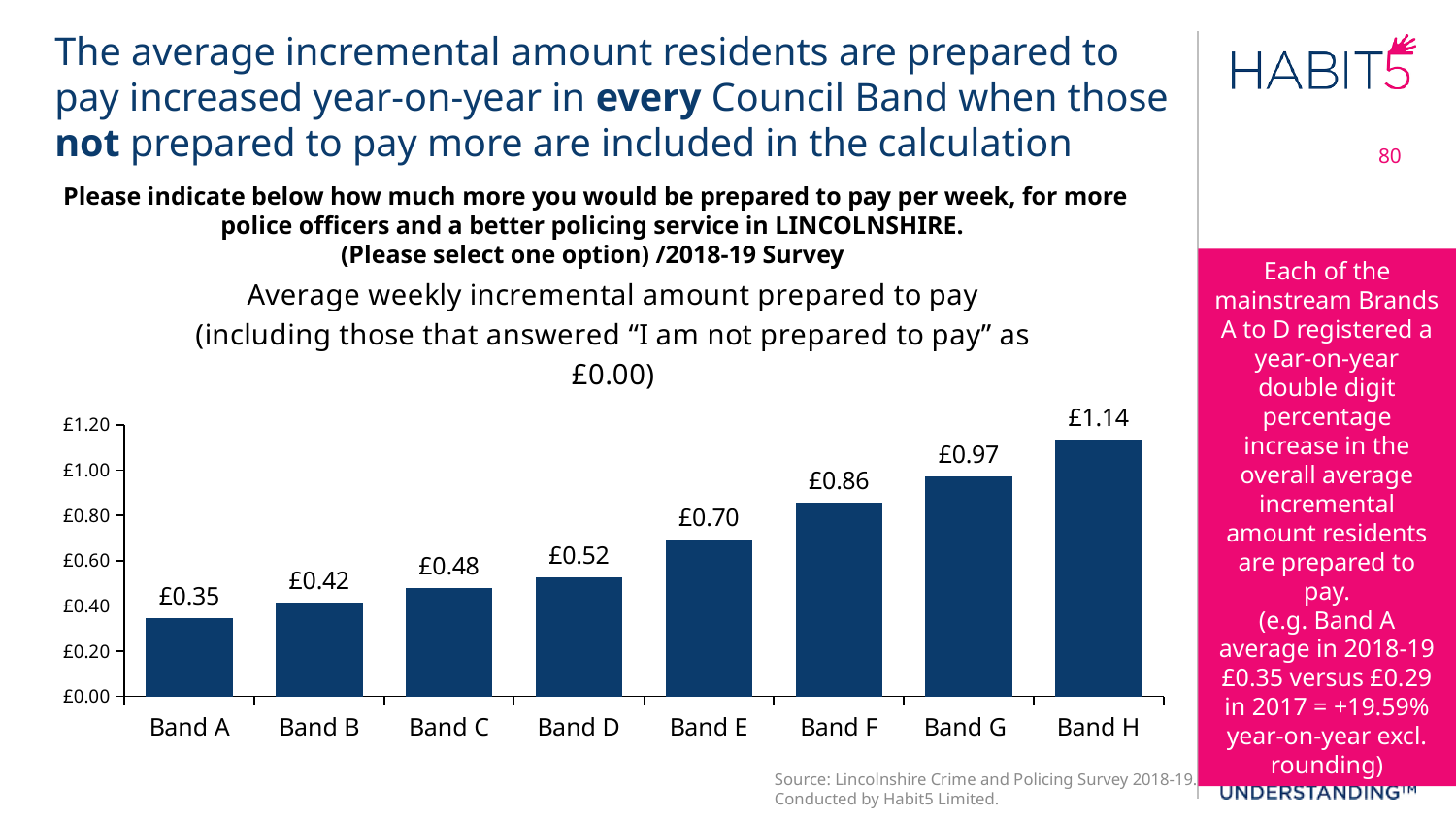
What is the value shown for Band E? £0.70 What is the difference between the values for Band H and Band A? £0.79 Is the value for Band G greater or less than £1.00? less What is the average weekly incremental amount prepared to pay for Band A? £0.35 Do the values rise or fall from Band A to Band H? rise What is the difference between the values for Band F and Band D? £0.34 What kind of chart is shown on the slide? bar chart Which is larger, the value for Band C or the value for Band F? Band F How many Council Bands are shown on the chart? 8 Which Council Band has the lowest average weekly incremental amount? Band A Which Council Band has the highest average weekly incremental amount? Band H What is the value shown for Band G? £0.97